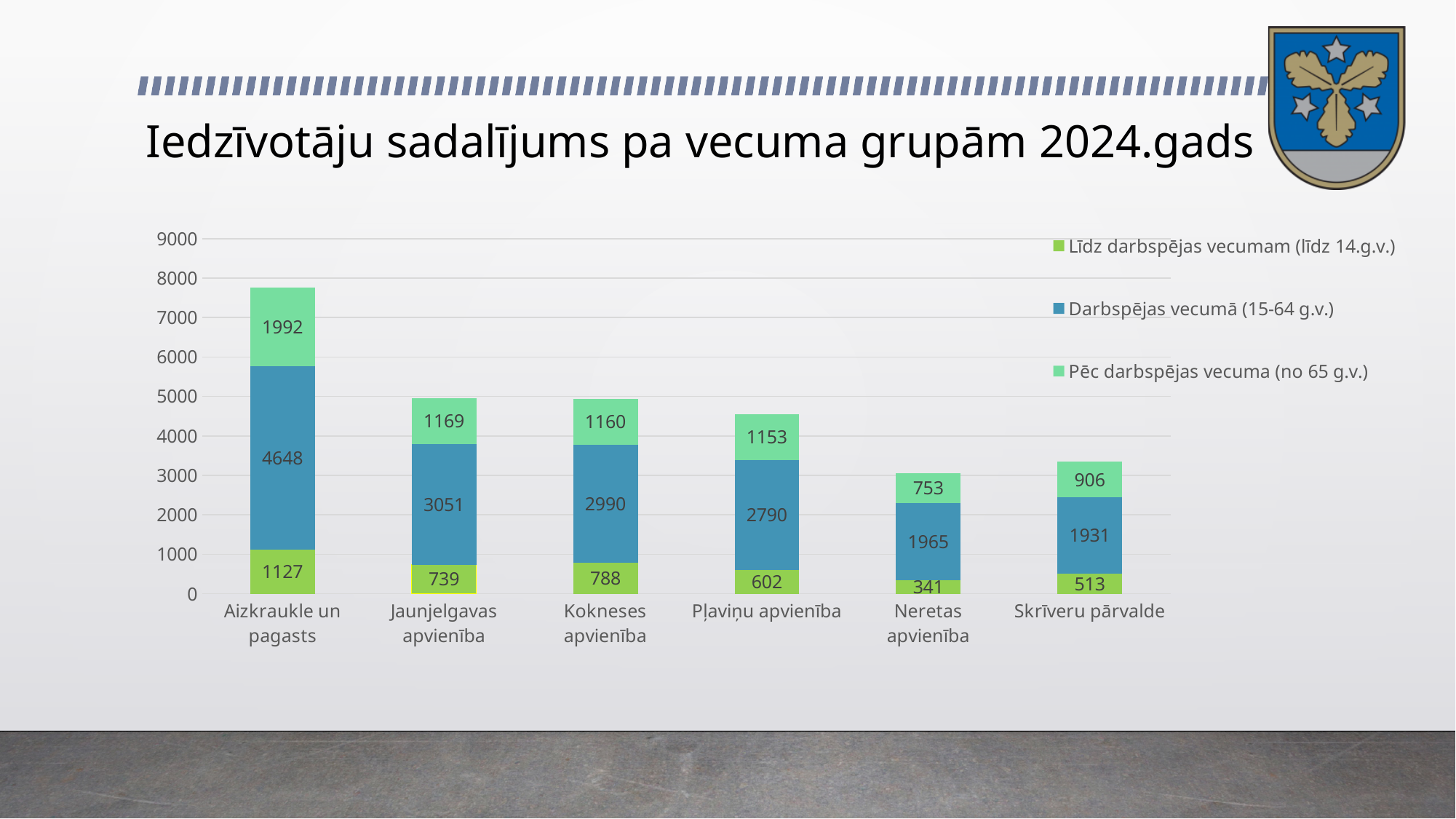
Which category has the shortest stacked bar overall? Neretas apvienība What is the total of the stacked bar for Neretas apvienība? 3059 How many series does the legend list? 3 Which is larger: the Pēc darbspējas vecuma (no 65 g.v.) value for Pļaviņu apvienība or for Neretas apvienība? Pļaviņu apvienība What is the value for Līdz darbspējas vecumam (līdz 14.g.v.) in Neretas apvienība? 341 Which category has the tallest stacked bar overall? Aizkraukle un pagasts What kind of chart is shown on the slide? Stacked bar chart What is the value for Pēc darbspējas vecuma (no 65 g.v.) in Skrīveru pārvalde? 906 What is the difference between the Darbspējas vecumā (15-64 g.v.) values for Jaunjelgavas apvienība and Kokneses apvienība? 61 How many categories are shown on the x axis? 6 What is the value for Darbspējas vecumā (15-64 g.v.) in Aizkraukle un pagasts? 4648 What is the total of the stacked bar for Pļaviņu apvienība? 4545